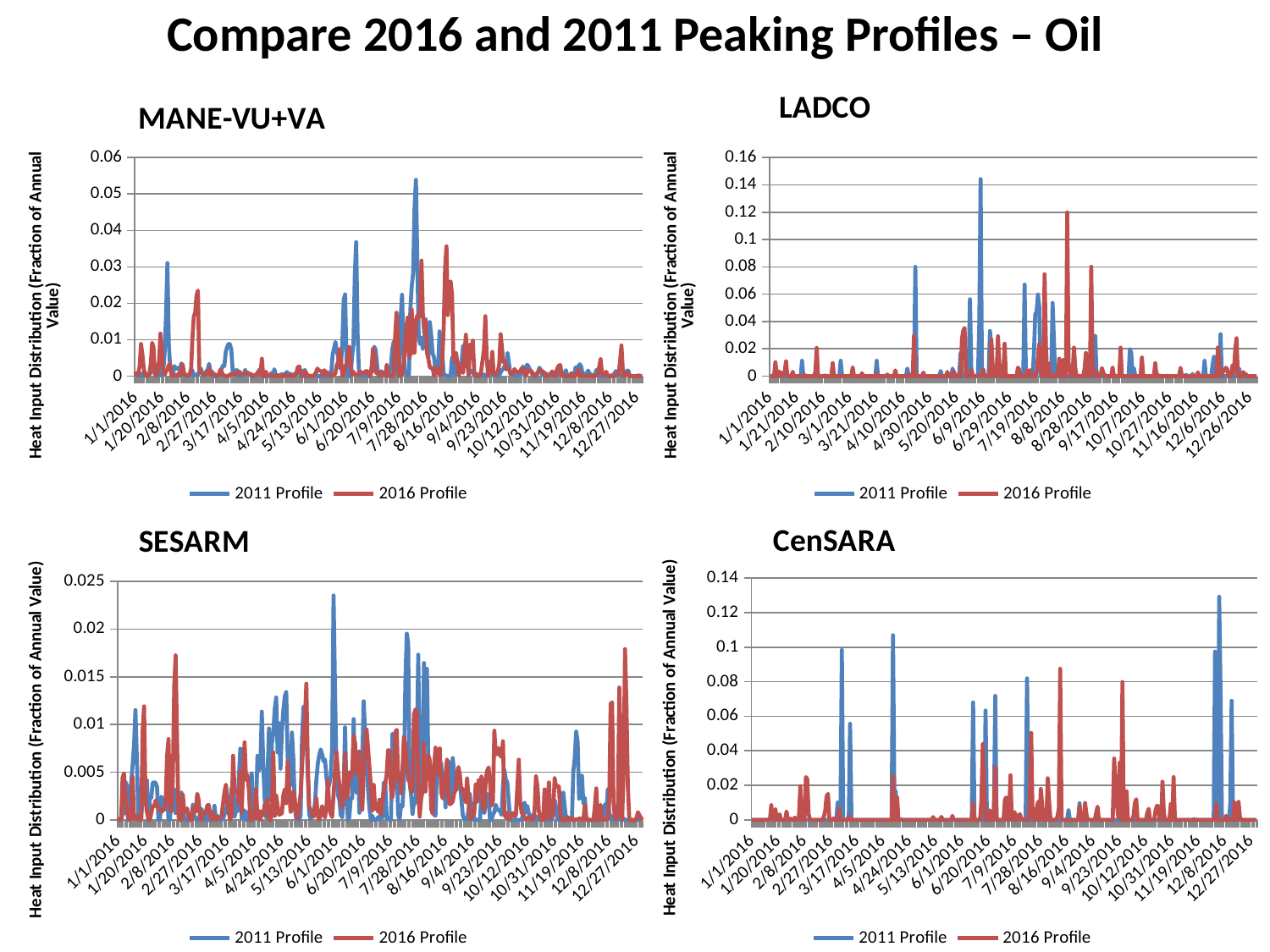
In the MANE-VU+VA chart, is the highest value of the 2011 Profile greater or less than 0.05? greater What are the two series named in the legend of the SESARM chart? 2011 Profile and 2016 Profile What kind of chart is the MANE-VU+VA chart? Line chart In the MANE-VU+VA chart, which series reaches the higher peak, 2011 Profile or 2016 Profile? 2011 Profile What is the y-axis title on the CenSARA chart? Heat Input Distribution (Fraction of Annual Value) In the LADCO chart, which series reaches the higher peak, 2011 Profile or 2016 Profile? 2011 Profile In the CenSARA chart, which series reaches the higher peak, 2011 Profile or 2016 Profile? 2011 Profile How many series does the legend of the LADCO chart list? 2 In the SESARM chart, is the highest value of the 2016 Profile greater or less than 0.015? greater In the LADCO chart, is the highest value of the 2011 Profile greater or less than 0.12? greater